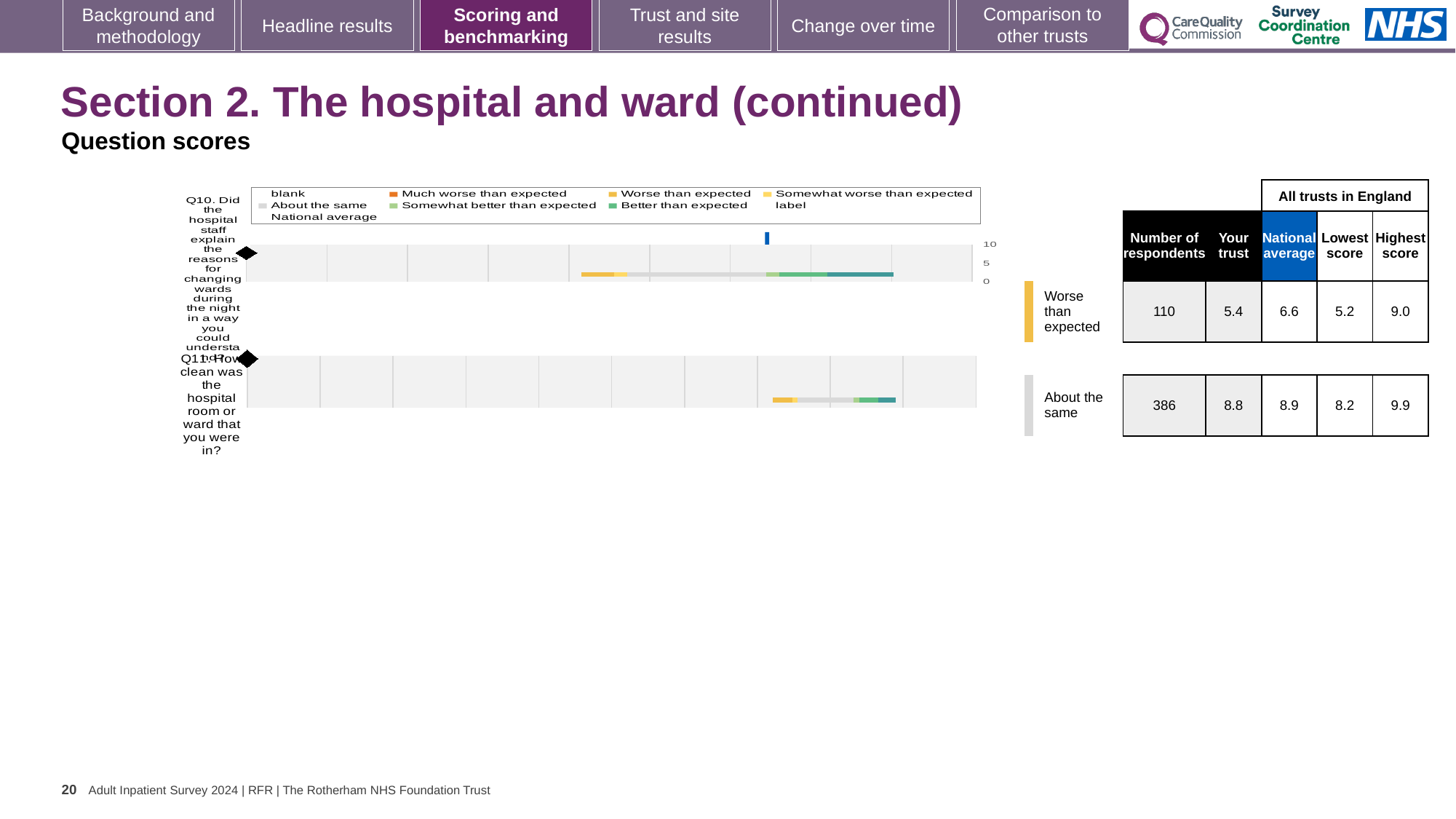
How many questions (Q10 and Q11) are plotted on the slide? 2 Which benchmark category is shown for Q10? Worse than expected For Q10 (explaining reasons for changing wards during the night), what is the 'Your trust' score? 5.4 For Q10, what is the national average score? 6.6 How many respondents answered Q11? 386 How many more respondents answered Q11 than Q10? 276 For Q11 (how clean was the hospital room or ward), what is the 'Your trust' score? 8.8 For Q11, which is larger: the 'Your trust' score or the national average? National average What kind of chart is used to show the question scores for Q10 and Q11? bar chart For Q10, what is the difference between the highest score and the lowest score among all trusts in England? 3.8 Which benchmark category is shown for Q11? About the same For Q10, what is the lowest score among all trusts in England? 5.2